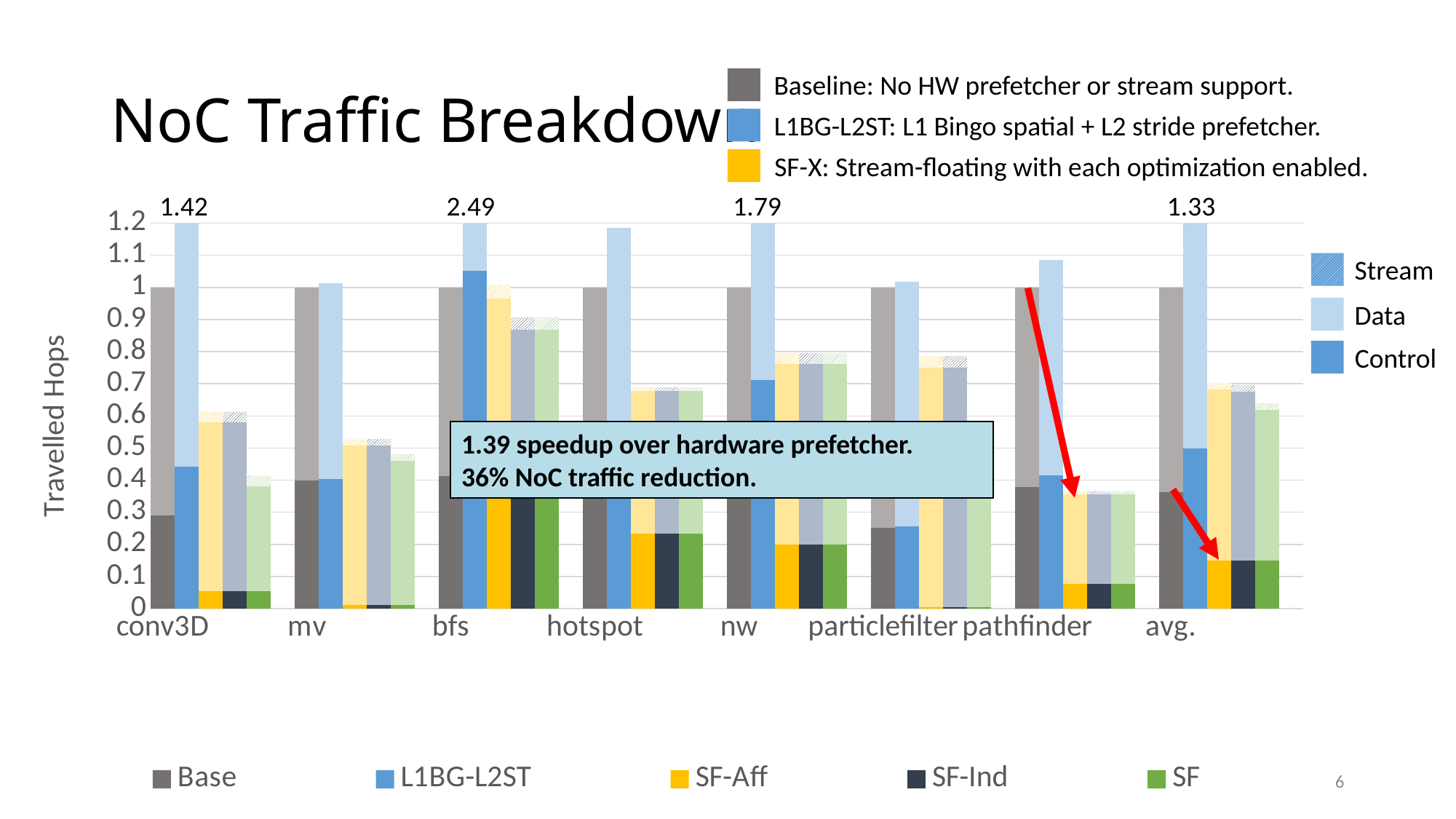
What is the label on the y axis of the chart? Travelled Hops What is the difference between the L1BG-L2ST values for bfs and conv3D? 1.07 Which is larger, the L1BG-L2ST value for nw or for conv3D? nw Is the L1BG-L2ST bar for hotspot greater or less than 1? greater What kind of chart is shown on the slide? bar chart How many series does the legend at the bottom of the chart list? 5 Is the SF bar for conv3D greater or less than 0.5? less What value is printed above the L1BG-L2ST bar for bfs? 2.49 How many categories are shown along the x axis of the chart? 8 What value is printed above the L1BG-L2ST bar for conv3D? 1.42 What value is printed above the L1BG-L2ST bar for avg.? 1.33 Which category has the highest L1BG-L2ST value? bfs